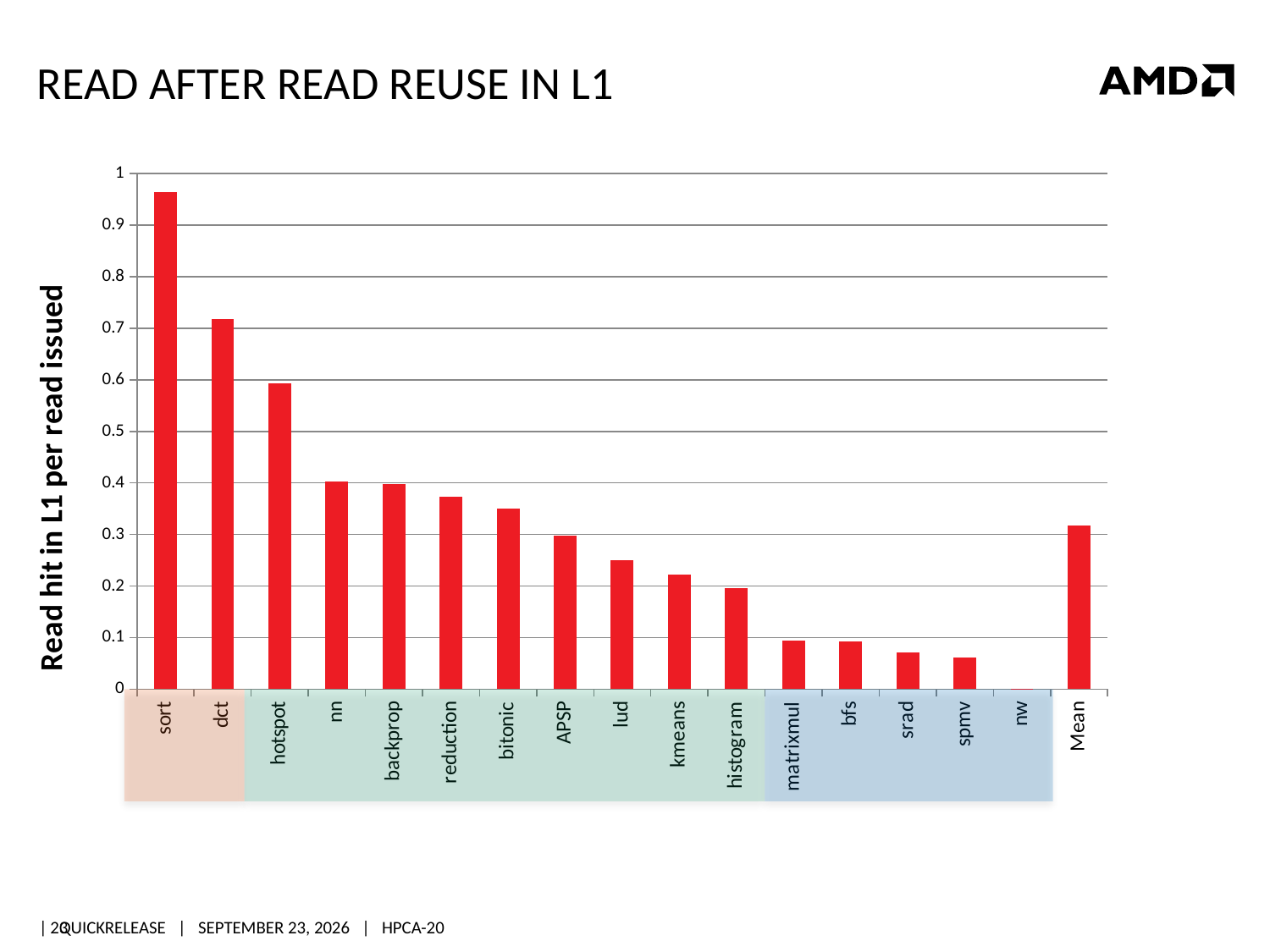
Excluding the Mean bar, do the values rise or fall moving from left to right along the x axis? fall Is the value for Mean greater or less than 0.3? greater What kind of chart is shown on the slide? bar chart Which is larger, the value for hotspot or the value for nn? hotspot What is the label of the y axis? Read hit in L1 per read issued Which category has the highest read hit in L1 per read issued? sort Is the value for reduction greater or less than 0.4? less Which category has the lowest read hit in L1 per read issued? nw Is the value for sort greater or less than 0.9? greater How many categories are plotted on the x axis, including Mean? 17